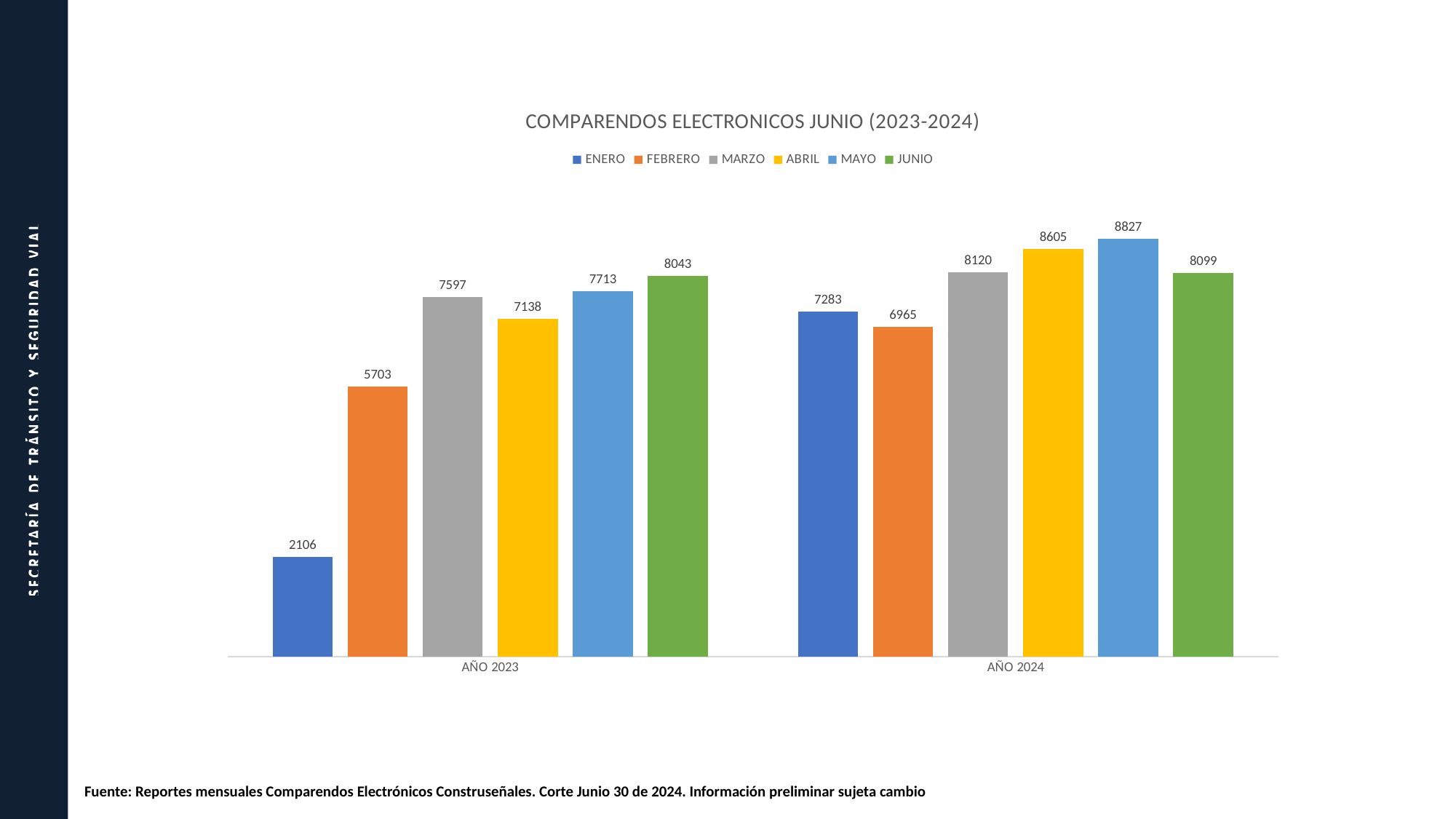
Which is larger, JUNIO in AÑO 2023 or JUNIO in AÑO 2024? JUNIO in AÑO 2024 What is the title of the chart? COMPARENDOS ELECTRONICOS JUNIO (2023-2024) Which month has the lowest value in AÑO 2023? ENERO What is the value for ENERO in AÑO 2023? 2106 What is the difference between the ENERO values for AÑO 2024 and AÑO 2023? 5177 What is the value for MAYO in AÑO 2024? 8827 What is the value for ABRIL in AÑO 2023? 7138 Which month has the highest value in AÑO 2024? MAYO How many series does the legend list? 6 What colour are the MARZO bars? Grey What kind of chart is shown? Bar chart How many categories are shown on the x axis? 2